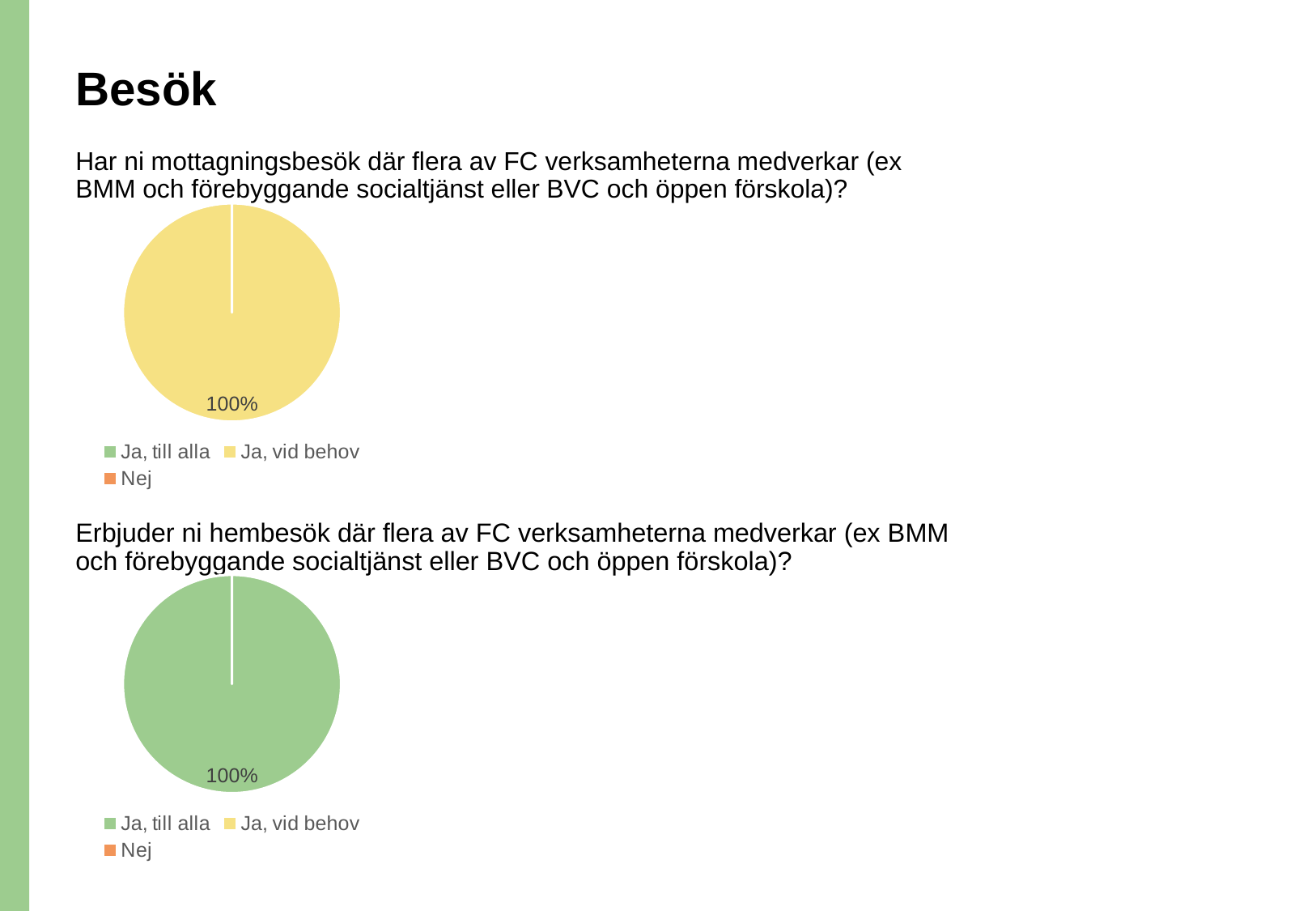
In the top pie chart (mottagningsbesök), what share is shown by the data label? 100% In the bottom pie chart (hembesök), which legend category does the single 100% slice belong to, judging by its colour? Ja, till alla What colour is the slice in the bottom pie chart (hembesök)? green What is the title of the slide containing the two pie charts? Besök How many entries does the legend of the top pie chart (mottagningsbesök) list? 3 In the bottom pie chart (hembesök), what share is shown by the data label? 100% What kind of chart is shown under the question about mottagningsbesök (top chart)? pie chart In the top pie chart (mottagningsbesök), which legend category does the single 100% slice belong to, judging by its colour? Ja, vid behov In the bottom pie chart (hembesök), which category has the largest share? Ja, till alla How many entries does the legend of the bottom pie chart (hembesök) list? 3 What kind of chart is shown under the question about hembesök (bottom chart)? pie chart In the top pie chart (mottagningsbesök), which category has the largest share? Ja, vid behov